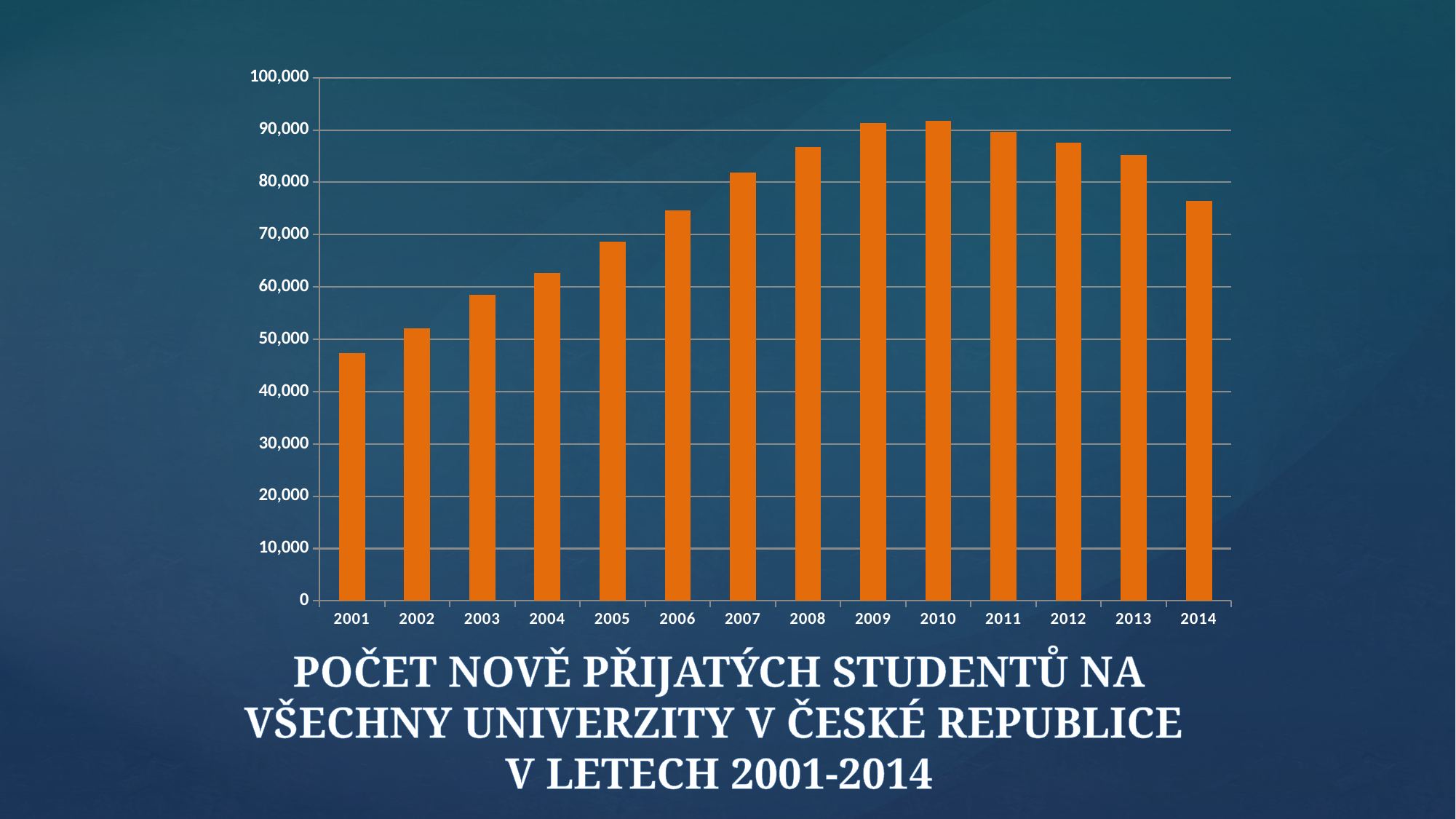
Which year has the larger value, 2013 or 2014? 2013 Is the value for 2014 greater or less than 80,000? less Which year has the lowest number of newly admitted students? 2001 What kind of chart is shown on the slide? bar chart Is the value for 2005 greater or less than 70,000? less Is the value for 2009 greater or less than 90,000? greater How do the values change from 2001 to 2010? they rise Which year has the larger value, 2003 or 2004? 2004 How many years (bars) are plotted on the chart? 14 What colour are the bars in the chart? orange